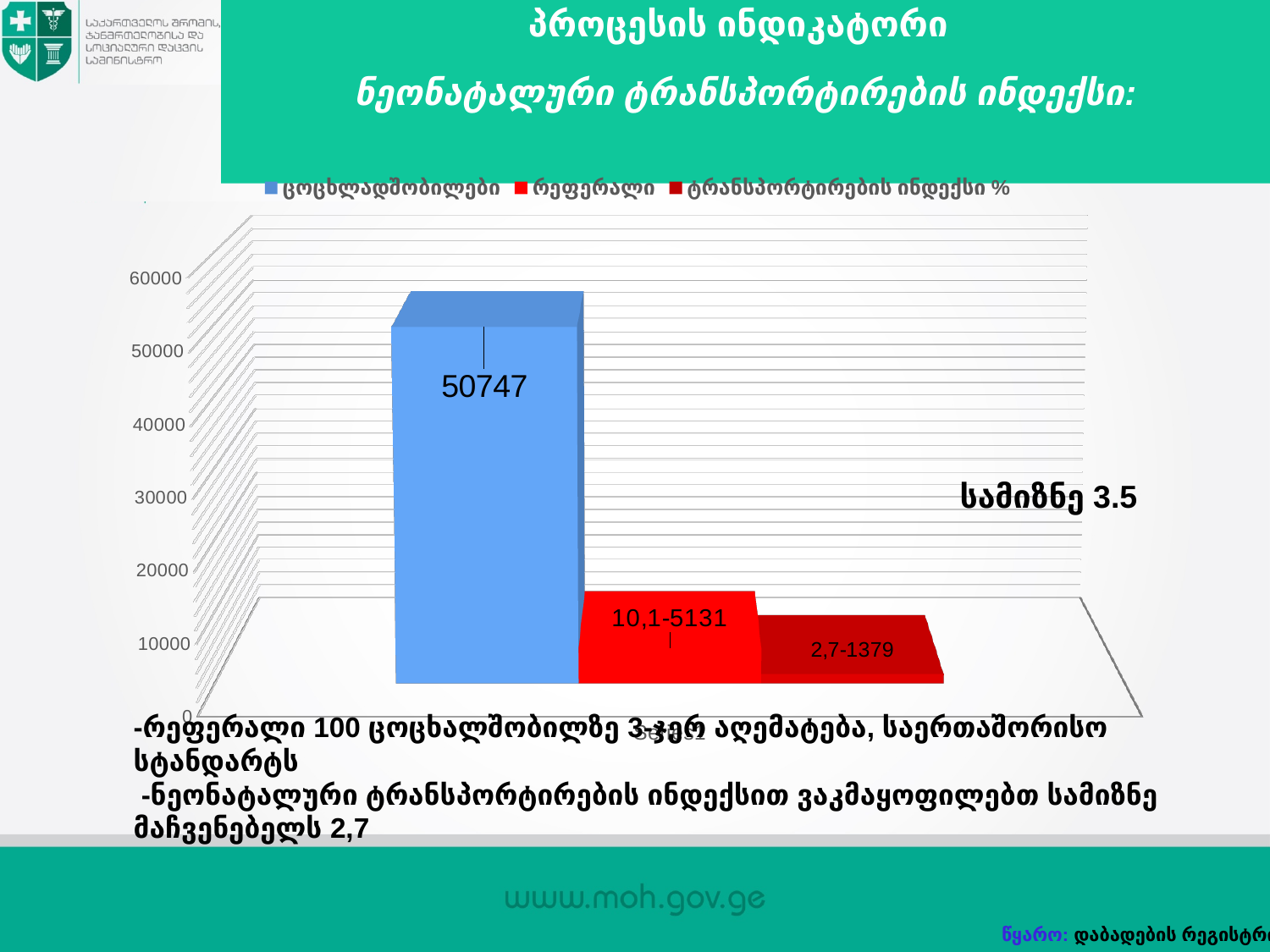
What kind of chart is shown on the slide? bar chart What is the highest value shown on the vertical axis? 60000 Is the value for რეფერალი greater or less than 20000? less What label is printed on the dark red bar for ტრანსპორტირების ინდექსი %? 2,7-1379 Which series has the tallest bar? ცოცხლადშობილები How many series does the legend list? 3 What colour is used for the რეფერალი series in the legend? red What label is printed on the red bar for რეფერალი? 10,1-5131 Is the value for ცოცხალდშობილები greater or less than 50000? greater Which bar is taller, ცოცხალდშობილები or რეფერალი? ცოცხლადშობილები Which series has the shortest bar? ტრანსპორტირების ინდექსი % What value is labelled on the blue bar for ცოცხალდშობილები? 50747